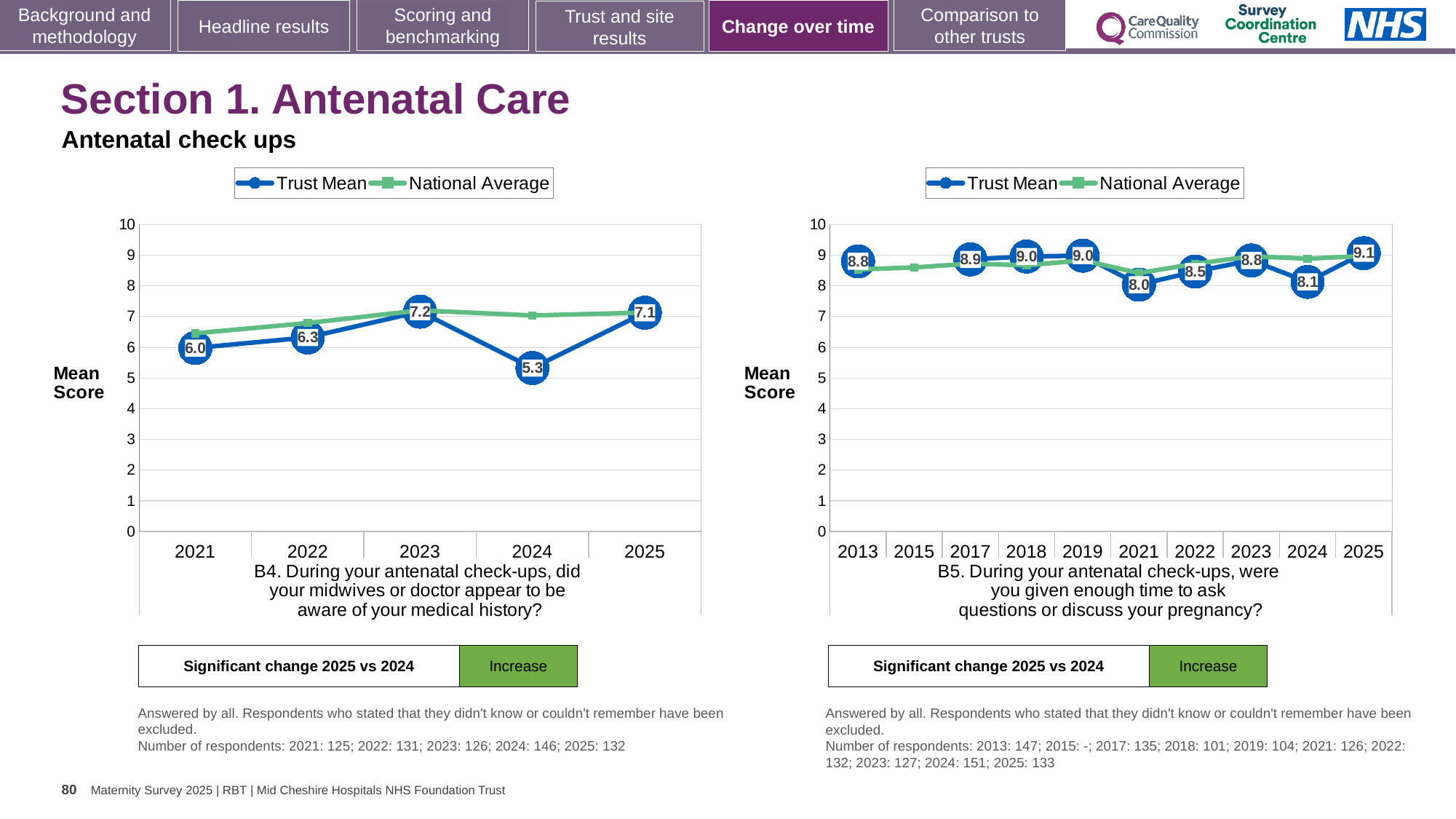
In the B5 chart on the right, what is the Trust Mean for 2021? 8.0 How many series does the legend of the B5 chart on the right list? 2 In the B4 chart on the left, what is the difference between the Trust Mean for 2025 and 2024? 1.8 In the B4 chart on the left, which year has the highest Trust Mean? 2023 In the B4 chart on the left, how many years are shown on the x axis? 5 In the B5 chart on the right, what is the Trust Mean for 2025? 9.1 In the B5 chart on the right, which year has the highest Trust Mean? 2025 In the B5 chart on the right, is the Trust Mean for 2024 larger or smaller than the Trust Mean for 2023? smaller In the B4 chart on the left, which year has the lowest Trust Mean? 2024 In the B4 chart on the left, what is the Trust Mean for 2024? 5.3 What type of chart is the B4 chart on the left? line chart In the B4 chart on the left, what is the Trust Mean for 2023? 7.2